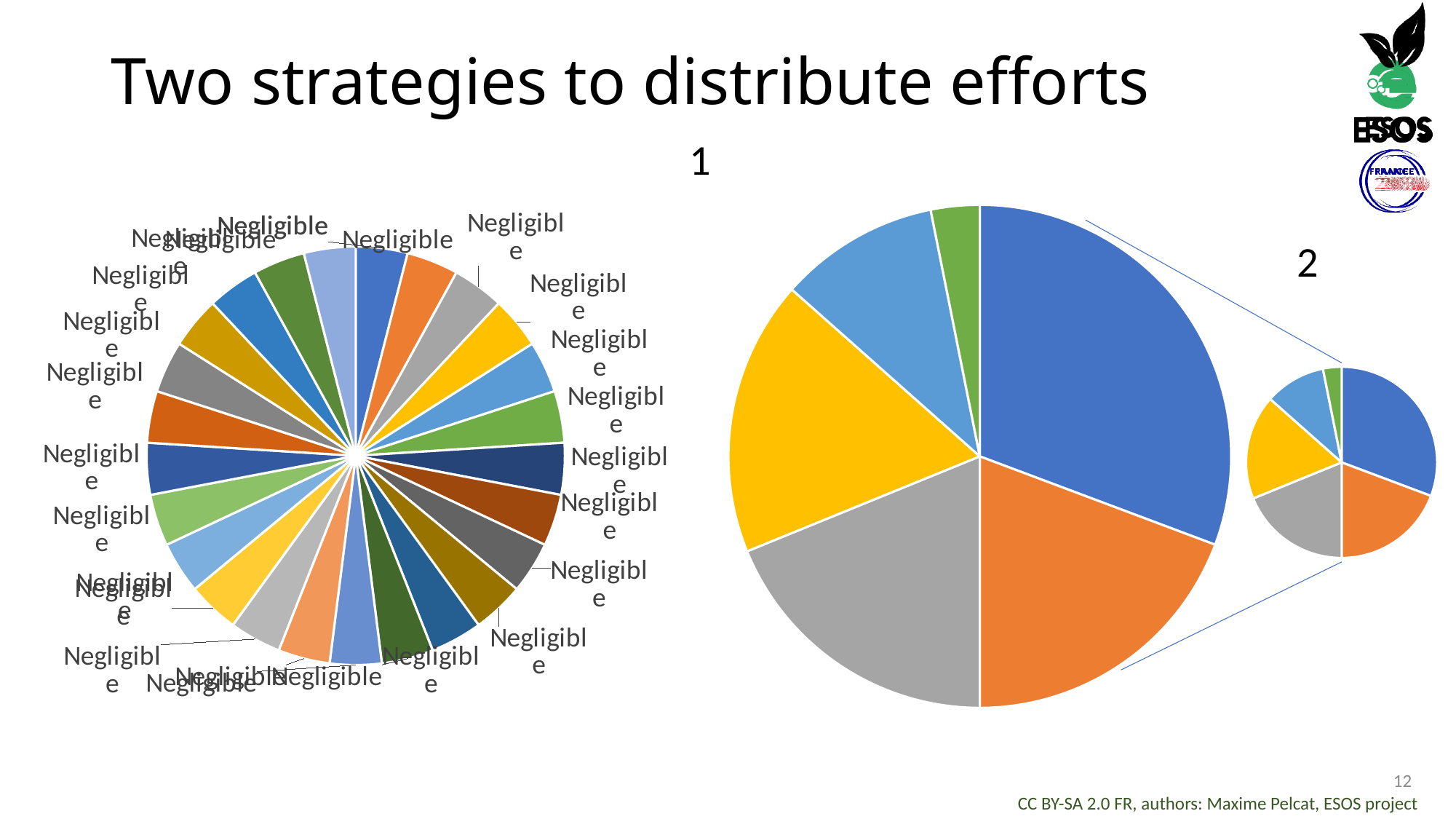
In the large pie chart on the right (labelled 2), which colour slice is the smallest? green In the large pie chart on the right (labelled 2), which colour slice is the largest? blue What kind of chart is the chart on the left side of the slide (labelled 1)? pie chart In the large pie chart on the right (labelled 2), which is larger: the blue slice or the green slice? the blue slice In the small pie chart at the far right, which colour slice is the largest? blue In the small pie chart at the far right of the slide, how many slices are there? 6 In the large pie chart on the right (labelled 2), how many slices are there? 6 How many pie charts are shown on the slide? 3 What is the title of the slide containing the pie charts? Two strategies to distribute efforts What kind of chart is the large chart on the right side of the slide (labelled 2)? pie chart In the large pie chart on the right (labelled 2), which is larger: the orange slice or the light blue slice? the orange slice In the pie chart on the left (labelled 1), what data label is shown on the slices? Negligible